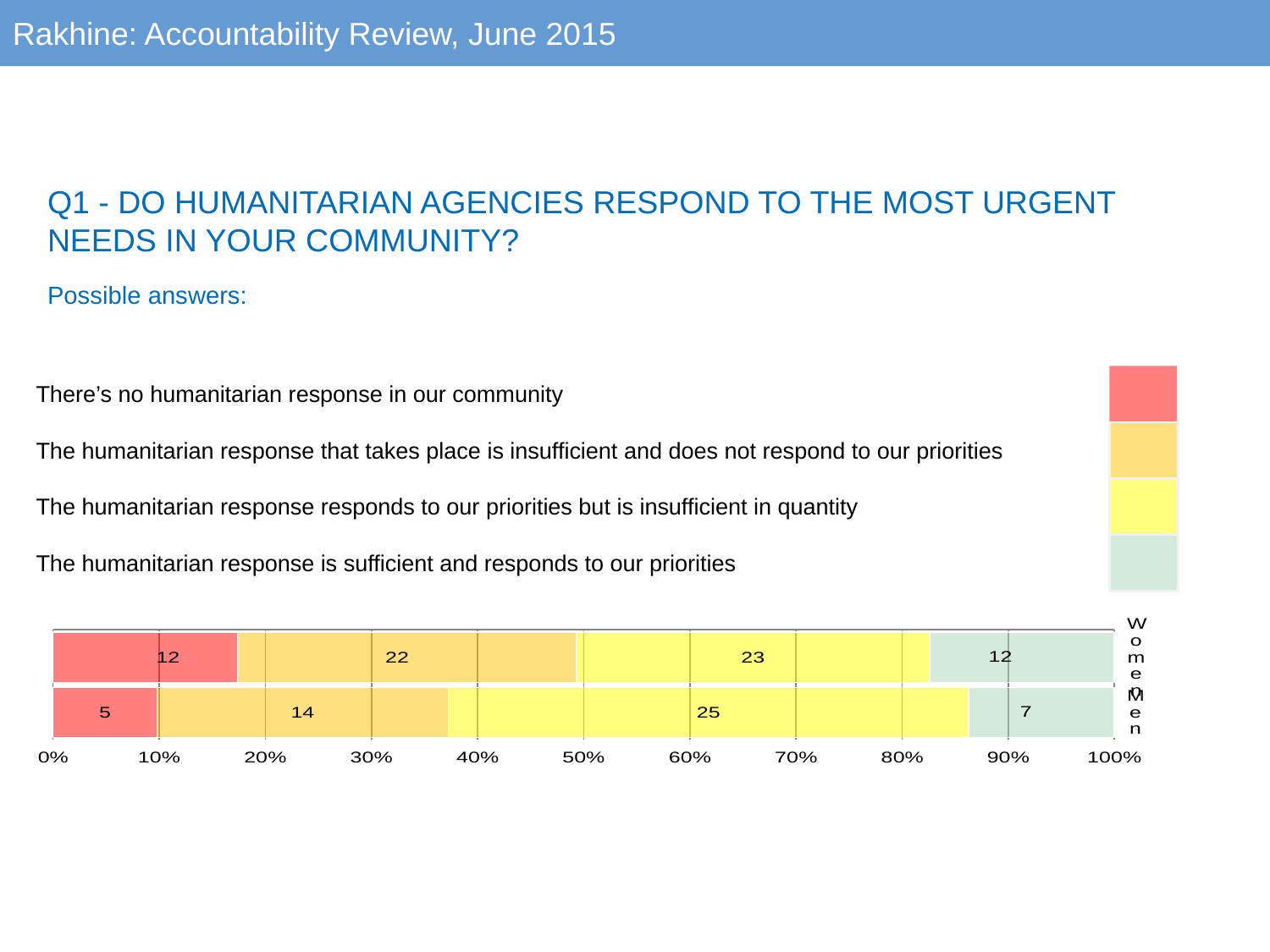
What is the total of all segments in the Men bar? 51 What is the value of the orange segment (The humanitarian response that takes place is insufficient and does not respond to our priorities) for Women? 22 What is the value of the yellow segment (The humanitarian response responds to our priorities but is insufficient in quantity) for Men? 25 What is the difference between the red segment values for Women and Men? 7 Which is larger: the orange segment for Women or the orange segment for Men? Women What is the total of all segments in the Women bar? 69 Which segment has the highest value in the Men bar? The humanitarian response responds to our priorities but is insufficient in quantity (25) What kind of chart is shown on the slide? Stacked bar chart How many categories (bars) does the chart show? 2 What is the value of the red segment (There's no humanitarian response in our community) for Women? 12 Which segment has the lowest value in the Men bar? There's no humanitarian response in our community (5) What is the value of the green segment (The humanitarian response is sufficient and responds to our priorities) for Men? 7